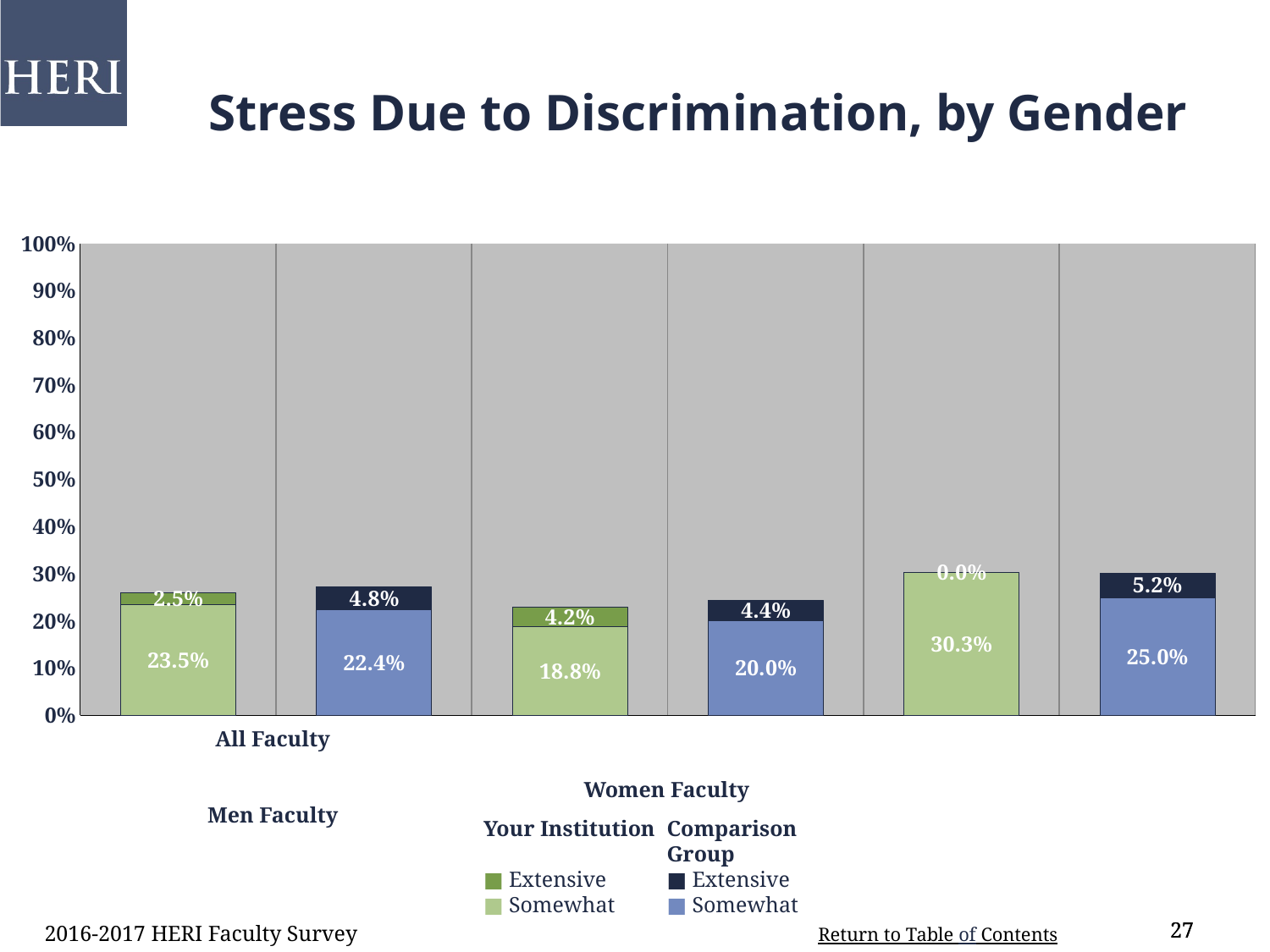
Which faculty group has the highest 'Somewhat' value for Your Institution? Women Faculty What is the difference between the 'Somewhat' values for Your Institution and the Comparison Group among Women Faculty? 5.3% What kind of chart is shown on the slide? Stacked bar chart What is the title of the chart? Stress Due to Discrimination, by Gender What is the 'Extensive' value for the Comparison Group among Women Faculty? 5.2% Which faculty group has the lowest 'Extensive' value for Your Institution? Women Faculty What is the 'Somewhat' value for Your Institution among Women Faculty? 30.3% What is the total of the stacked bar for the Comparison Group among All Faculty? 27.2% What is the total of the stacked bar for Your Institution among Men Faculty? 23.0% What is the 'Somewhat' value for Your Institution among All Faculty? 23.5% Which is larger: the 'Somewhat' value for Your Institution among Men Faculty or for the Comparison Group among Men Faculty? Comparison Group What is the 'Extensive' value for Your Institution among Men Faculty? 4.2%